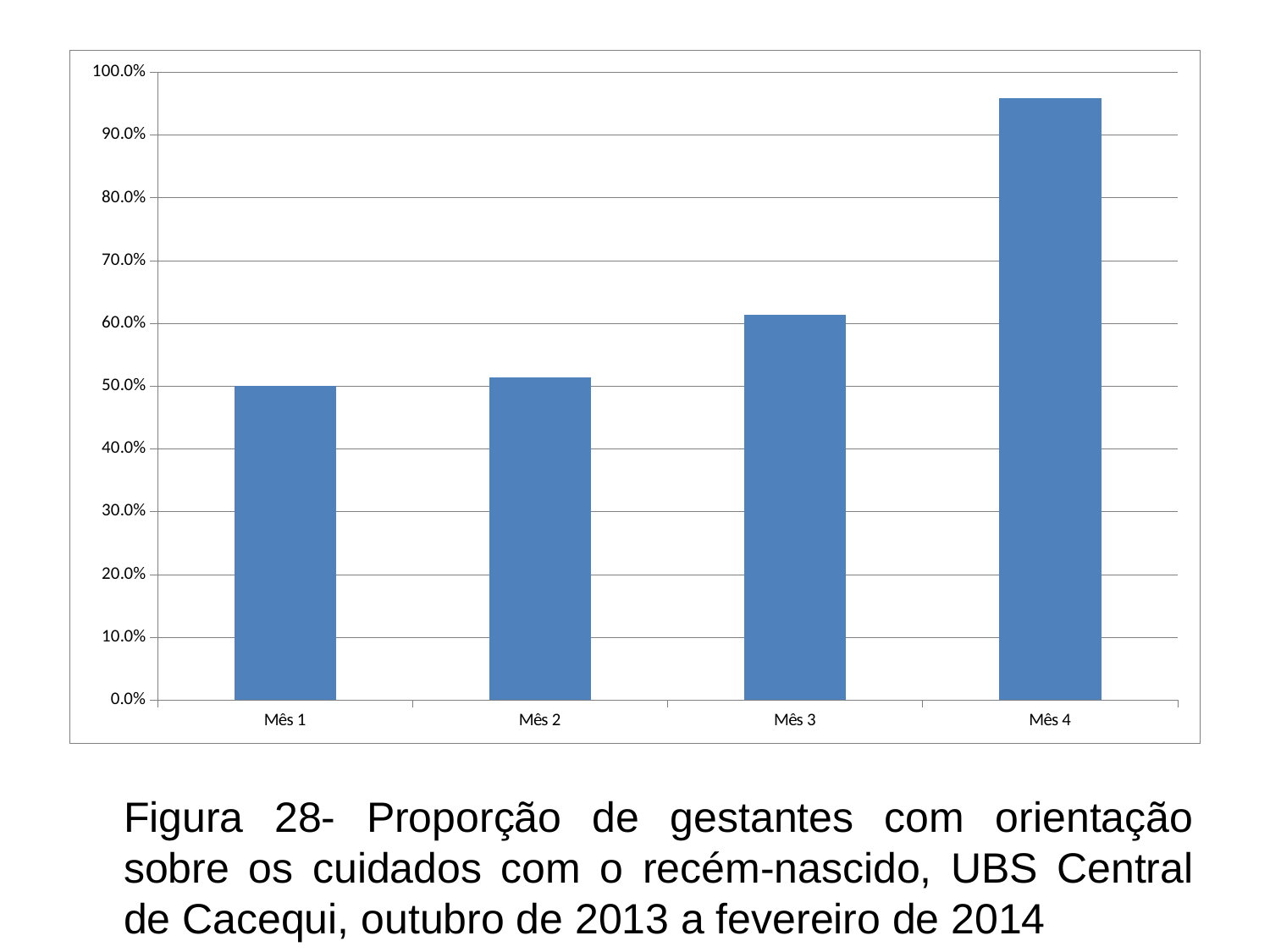
Is the value for Mês 3 greater or less than 50.0%? greater Is the value for Mês 3 greater or less than 70.0%? less Do the values rise or fall from Mês 1 to Mês 4? rise What is the highest value shown on the y axis? 100.0% What is the figure number given in the caption below the chart? Figura 28 Which is larger, the value for Mês 3 or the value for Mês 2? Mês 3 What kind of chart is shown on the slide? bar chart Which is larger, the value for Mês 4 or the value for Mês 1? Mês 4 Is the value for Mês 2 greater or less than 60.0%? less How many categories (months) are plotted on the x axis? 4 Which month has the highest value? Mês 4